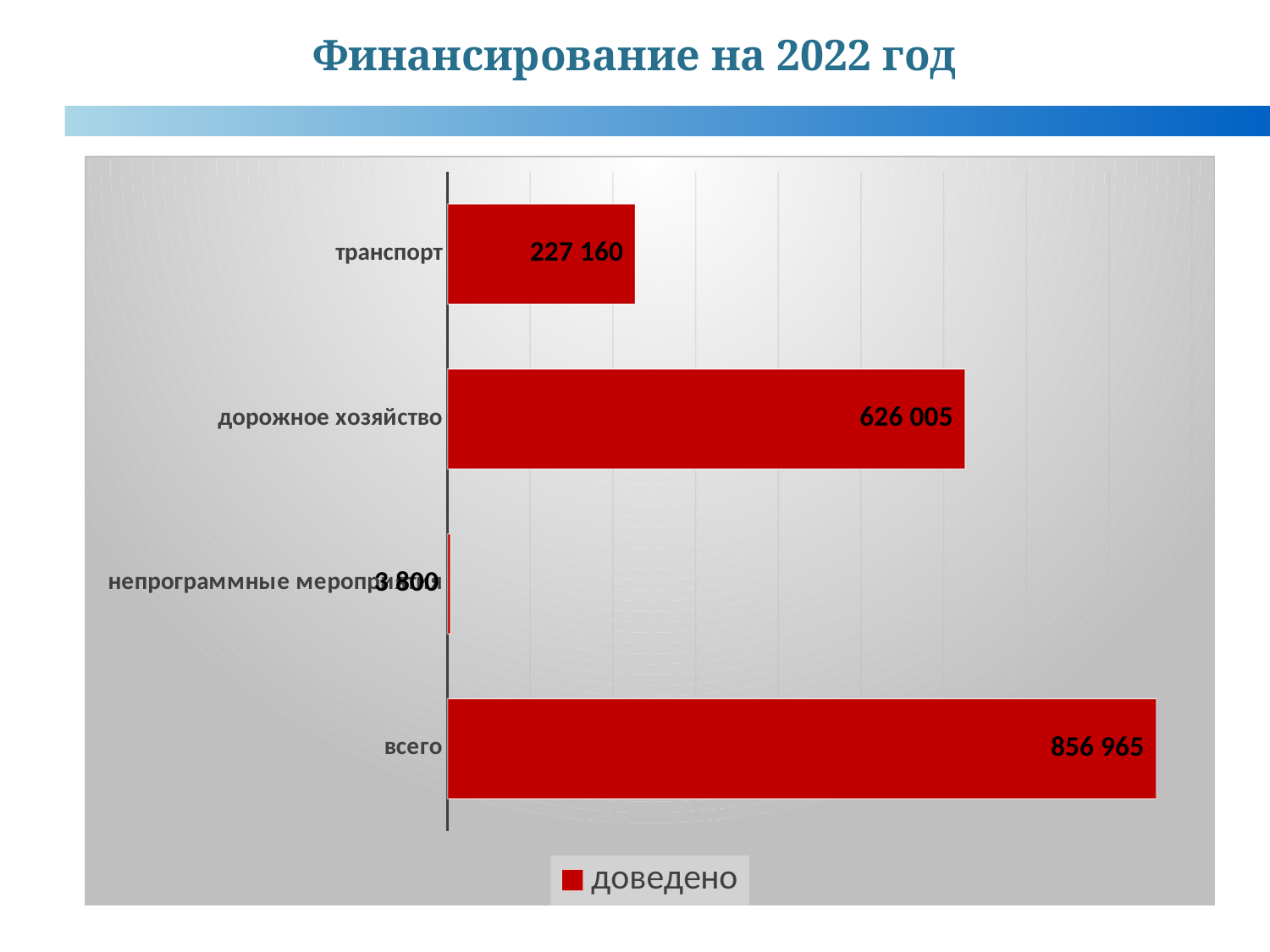
What is the difference between the values for дорожное хозяйство and транспорт? 398 845 What is the value for дорожное хозяйство? 626 005 What is the difference between the values for всего and дорожное хозяйство? 230 960 Which category has the lowest value? непрограммные мероприятия What is the value for всего? 856 965 What is the value for транспорт? 227 160 How many categories are shown in the chart? 4 What is the value for непрограммные мероприятия? 3 800 What kind of chart is shown on the slide? bar chart Which is larger, the value for транспорт or the value for дорожное хозяйство? дорожное хозяйство Which category has the highest value? всего How many series does the legend list? 1